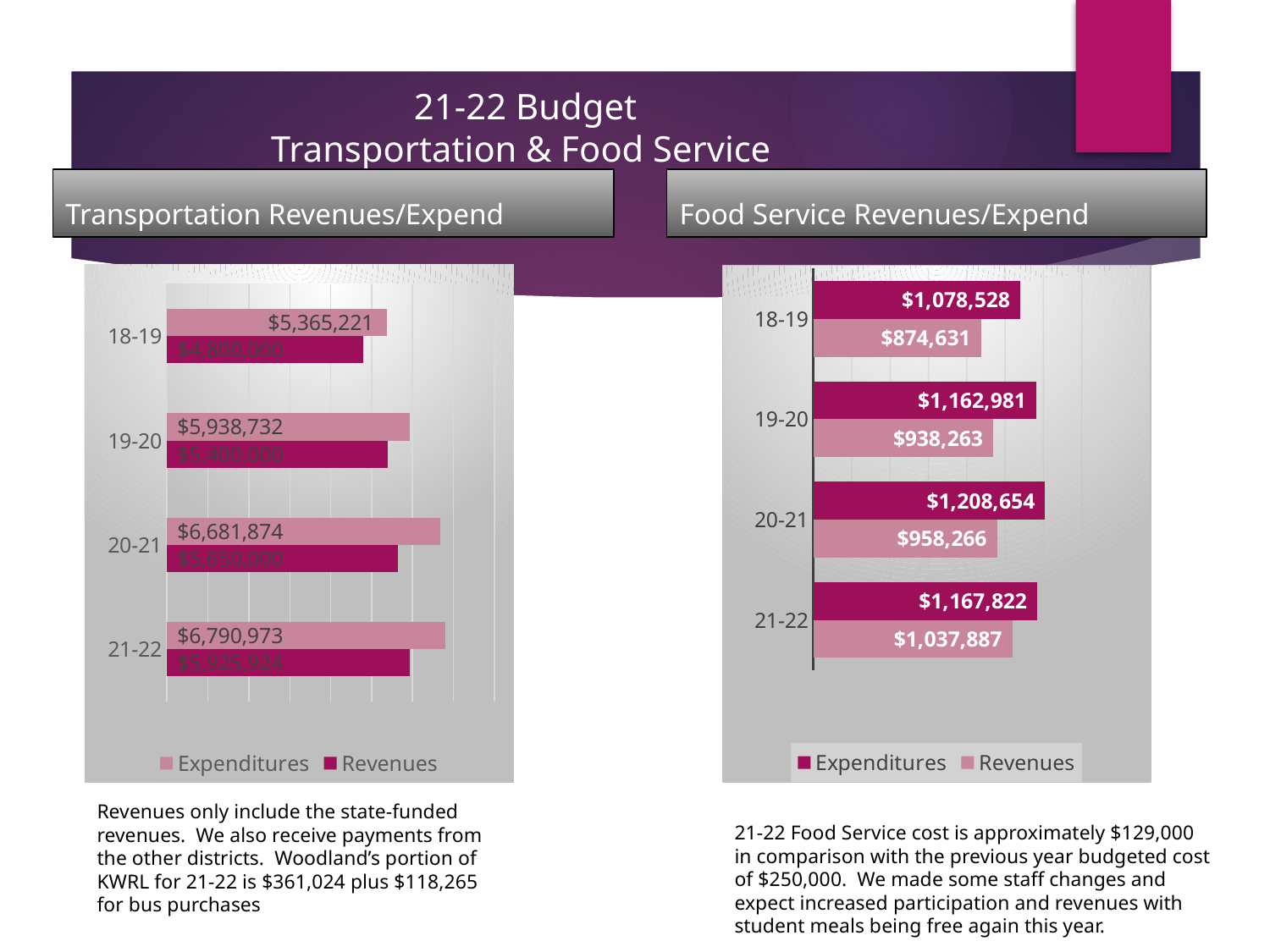
In the Food Service Revenues/Expend chart, which year has the lowest Revenues? 18-19 In the Food Service Revenues/Expend chart, what are the Expenditures for 20-21? $1,208,654 How many years are shown in the Transportation Revenues/Expend chart? 4 In the Transportation Revenues/Expend chart, what are the Expenditures for 21-22? $6,790,973 How many series does the legend of the Food Service Revenues/Expend chart list? 2 In the Transportation Revenues/Expend chart, what is the difference in Expenditures between 21-22 and 20-21? $109,099 In the Food Service Revenues/Expend chart, which year has the highest Expenditures? 20-21 In the Food Service Revenues/Expend chart, what are the Revenues for 21-22? $1,037,887 In the Food Service Revenues/Expend chart, do Revenues rise or fall from 18-19 to 21-22? rise In the Food Service Revenues/Expend chart, how much greater are Expenditures than Revenues for 21-22? $129,935 In the Food Service Revenues/Expend chart, which year has larger Expenditures, 19-20 or 21-22? 21-22 In the Transportation Revenues/Expend chart, what are the Expenditures for 18-19? $5,365,221